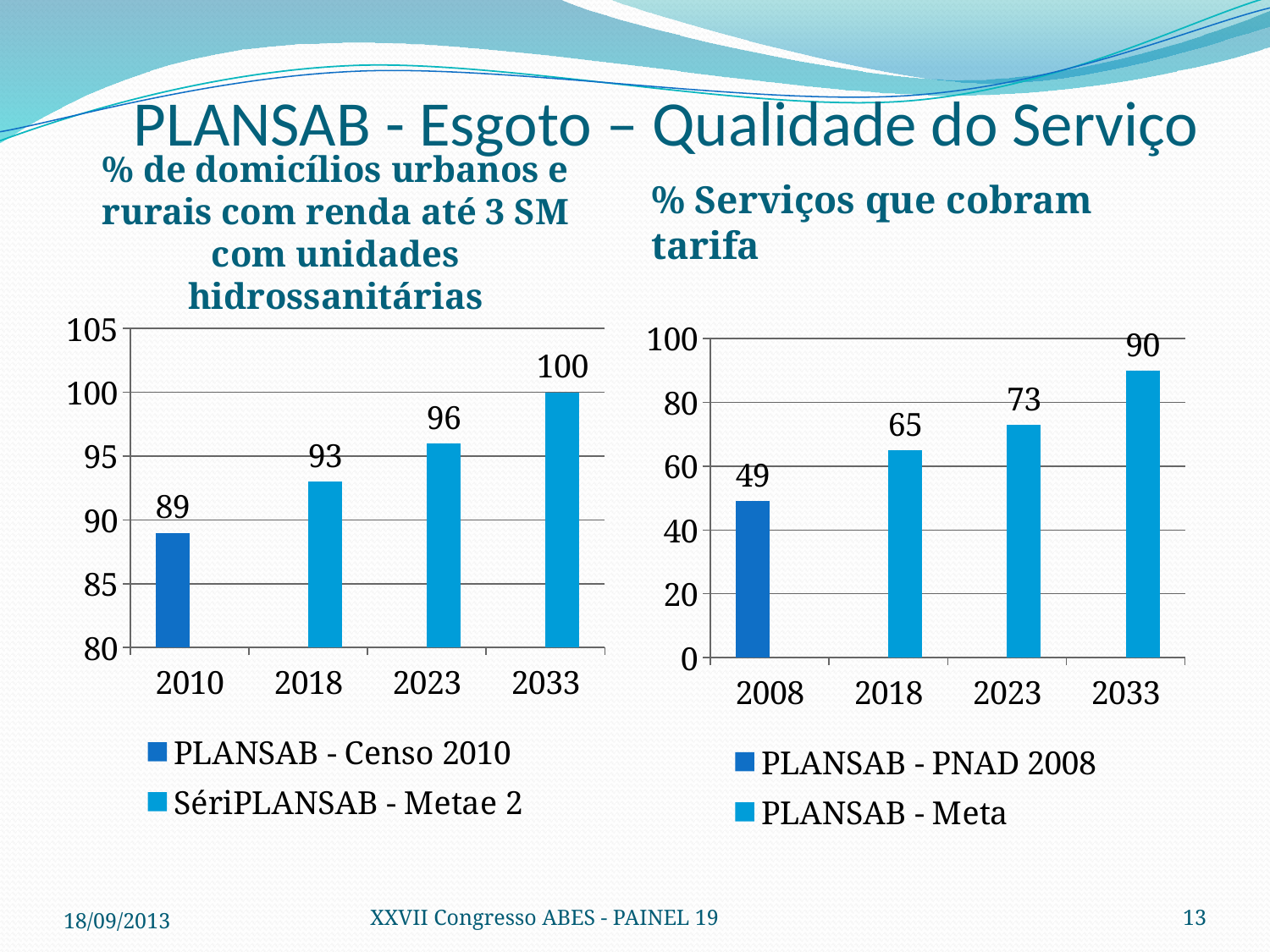
In the right chart (% Serviços que cobram tarifa), what is the value for 2018? 65 In the left chart (% de domicílios urbanos e rurais com renda até 3 SM com unidades hidrossanitárias), do the values rise or fall from 2010 to 2033? rise In the right chart (% Serviços que cobram tarifa), which is larger, the value for 2018 or the value for 2023? 2023 In the left chart (% de domicílios urbanos e rurais com renda até 3 SM com unidades hidrossanitárias), which year has the highest value? 2033 In the right chart (% Serviços que cobram tarifa), what is the difference between the values for 2033 and 2023? 17 In the right chart (% Serviços que cobram tarifa), which year has the lowest value? 2008 In the left chart (% de domicílios urbanos e rurais com renda até 3 SM com unidades hidrossanitárias), what is the value for 2023? 96 In the right chart (% Serviços que cobram tarifa), what is the value for 2008? 49 In the right chart (% Serviços que cobram tarifa), how many series does the legend list? 2 In the left chart (% de domicílios urbanos e rurais com renda até 3 SM com unidades hidrossanitárias), how many years are shown on the x axis? 4 In the left chart (% de domicílios urbanos e rurais com renda até 3 SM com unidades hidrossanitárias), what is the value for 2010? 89 In the left chart (% de domicílios urbanos e rurais com renda até 3 SM com unidades hidrossanitárias), what is the difference between the values for 2033 and 2010? 11